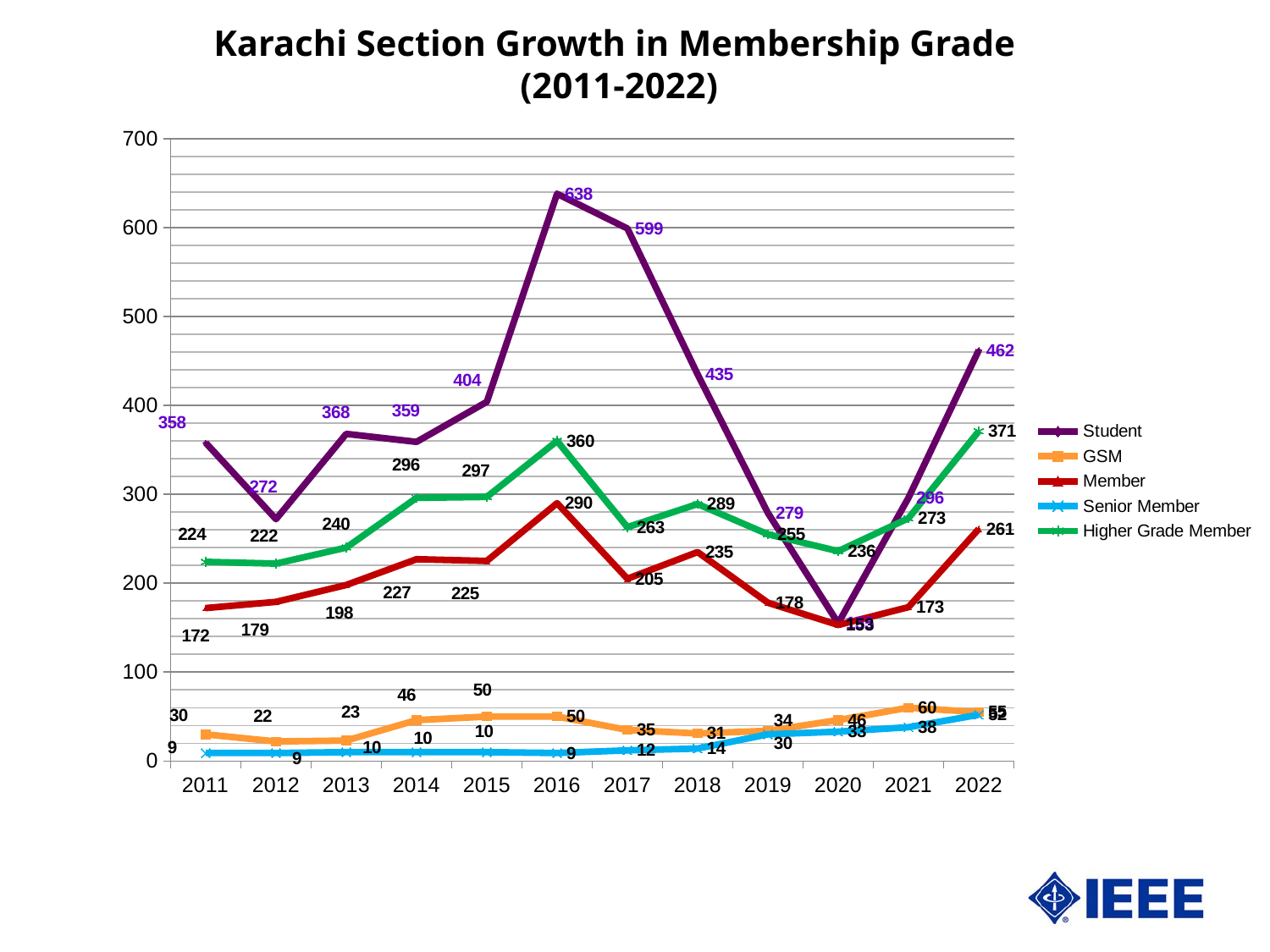
What kind of chart is shown on the slide? line chart What is the Student value in 2016? 638 Is the Student value in 2020 greater or less than 200? less In which year is the Student series highest? 2016 What is the Member value in 2016? 290 In which year is the Higher Grade Member series lowest? 2012 In 2014, which is larger: Higher Grade Member or Member? Higher Grade Member How many years are plotted along the x axis? 12 What is the Higher Grade Member value in 2022? 371 How many series does the legend list? 5 What is the GSM value in 2021? 60 What is the difference between the Student values in 2016 and 2017? 39